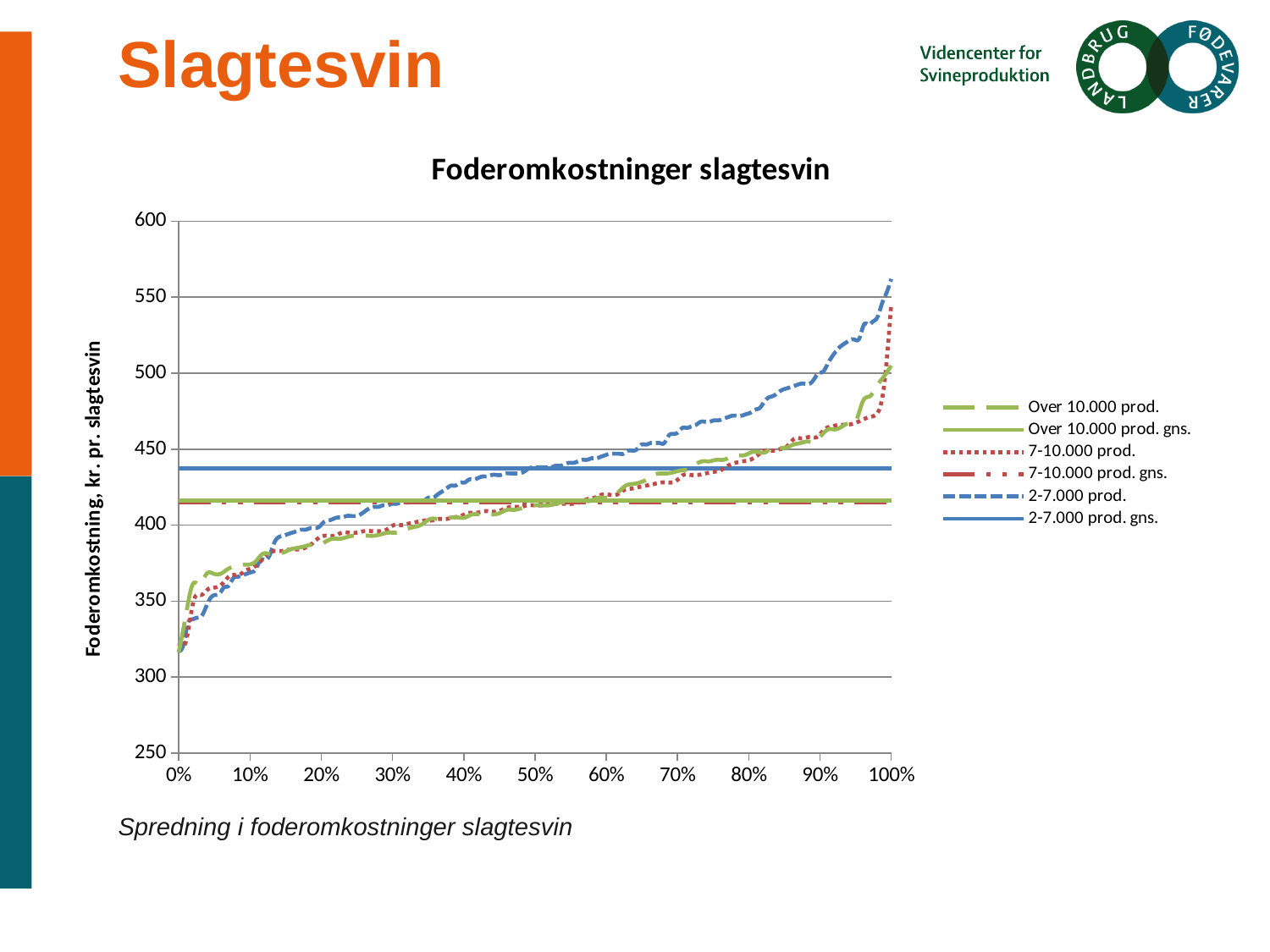
Do the values of the '2-7.000 prod.' series rise or fall as the x axis goes from 0% to 100%? rise Is the 'Over 10.000 prod. gns.' line greater or less than 400? greater Is the value of the '7-10.000 prod.' series at 100% greater or less than 500? greater Which of the three average (gns.) lines is the highest? 2-7.000 prod. gns. What kind of chart is shown on the slide? line chart Is the value of the '2-7.000 prod.' series at 100% greater or less than 550? greater At 100%, which is larger: the '2-7.000 prod.' series or the 'Over 10.000 prod.' series? 2-7.000 prod. What is the label of the vertical axis? Foderomkostning, kr. pr. slagtesvin What is the title of the chart? Foderomkostninger slagtesvin How many series does the legend list? 6